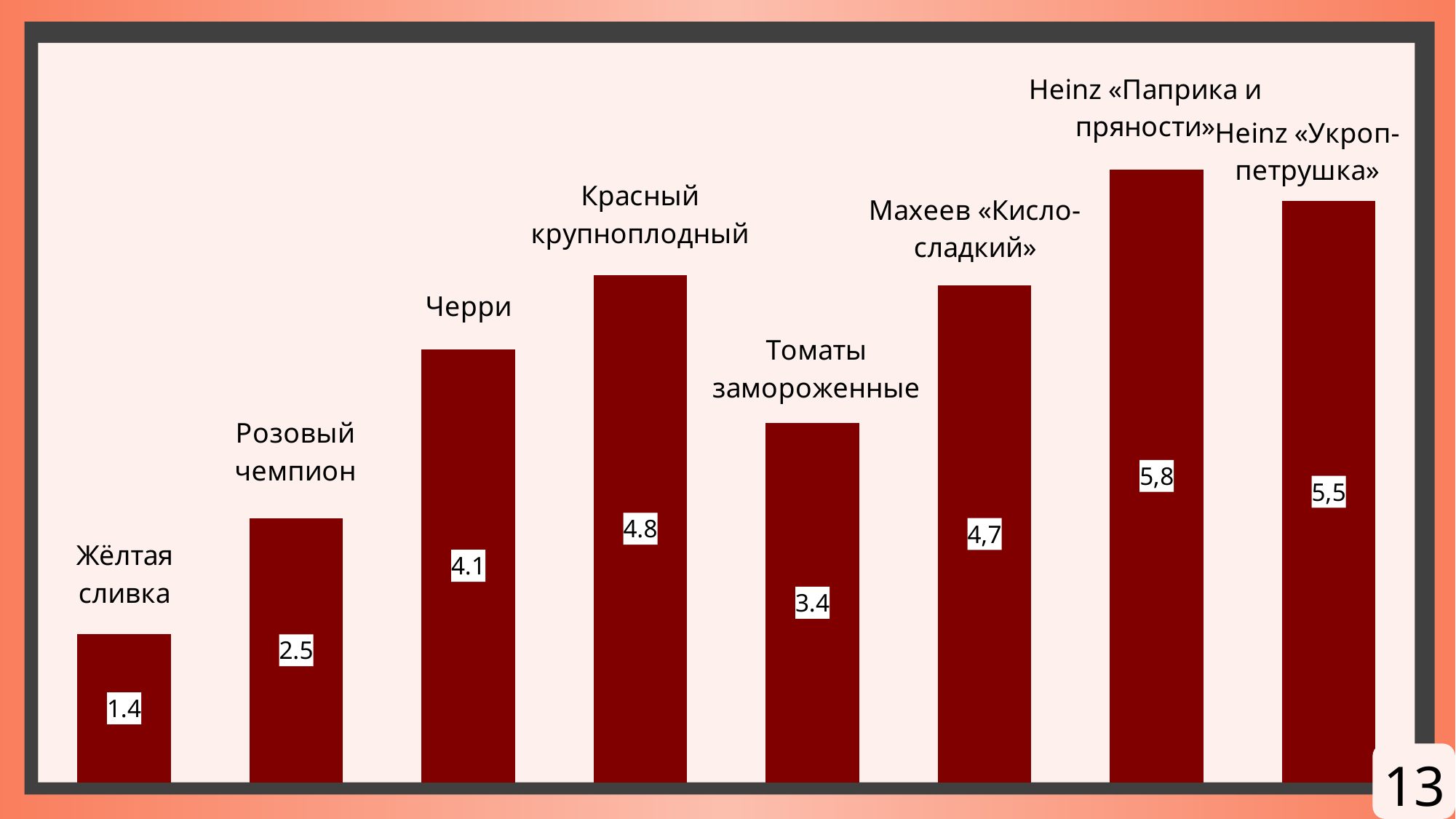
What is the value for Черри? 4.1 Which category has the lowest value? Жёлтая сливка What is the value for Heinz «Укроп-петрушка»? 5,5 What is the difference between the values for Красный крупноплодный and Жёлтая сливка? 3.4 What is the difference between the values for Heinz «Паприка и пряности» and Махеев «Кисло-сладкий»? 1,1 What is the value for Жёлтая сливка? 1.4 What kind of chart is shown on the slide? Bar chart What is the value for Томаты замороженные? 3.4 How many categories are shown in the chart? 8 What is the value for Махеев «Кисло-сладкий»? 4,7 Which category has the highest value? Heinz «Паприка и пряности» Which is larger, the value for Черри or the value for Томаты замороженные? Черри